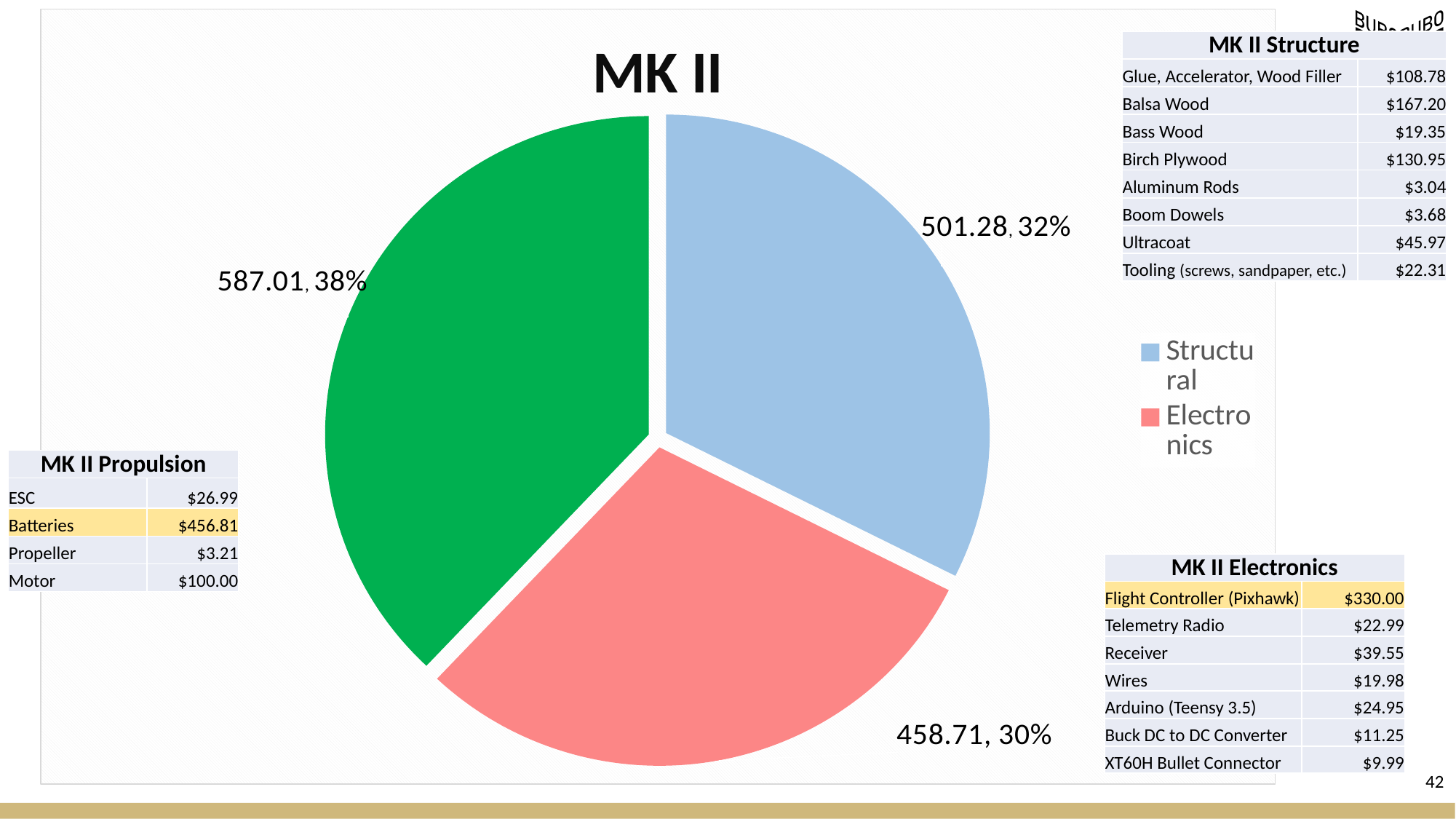
What share of the MK II pie does the Structural slice represent? 32% What is the value of the smallest slice in the MK II pie chart? 458.71 What kind of chart is the MK II chart? pie chart What colour is the Electronics slice in the MK II pie chart? red What is the title of the pie chart on the slide? MK II What share of the MK II pie does the Electronics slice represent? 30% What is the difference between the Structural and Electronics values in the MK II pie chart? 42.57 Which is larger in the MK II pie chart, the Structural slice or the Electronics slice? Structural What is the value shown for the Electronics slice in the MK II pie chart? 458.71 How many slices does the MK II pie chart have? 3 What is the value shown for the Structural slice in the MK II pie chart? 501.28 What is the value of the largest slice in the MK II pie chart? 587.01